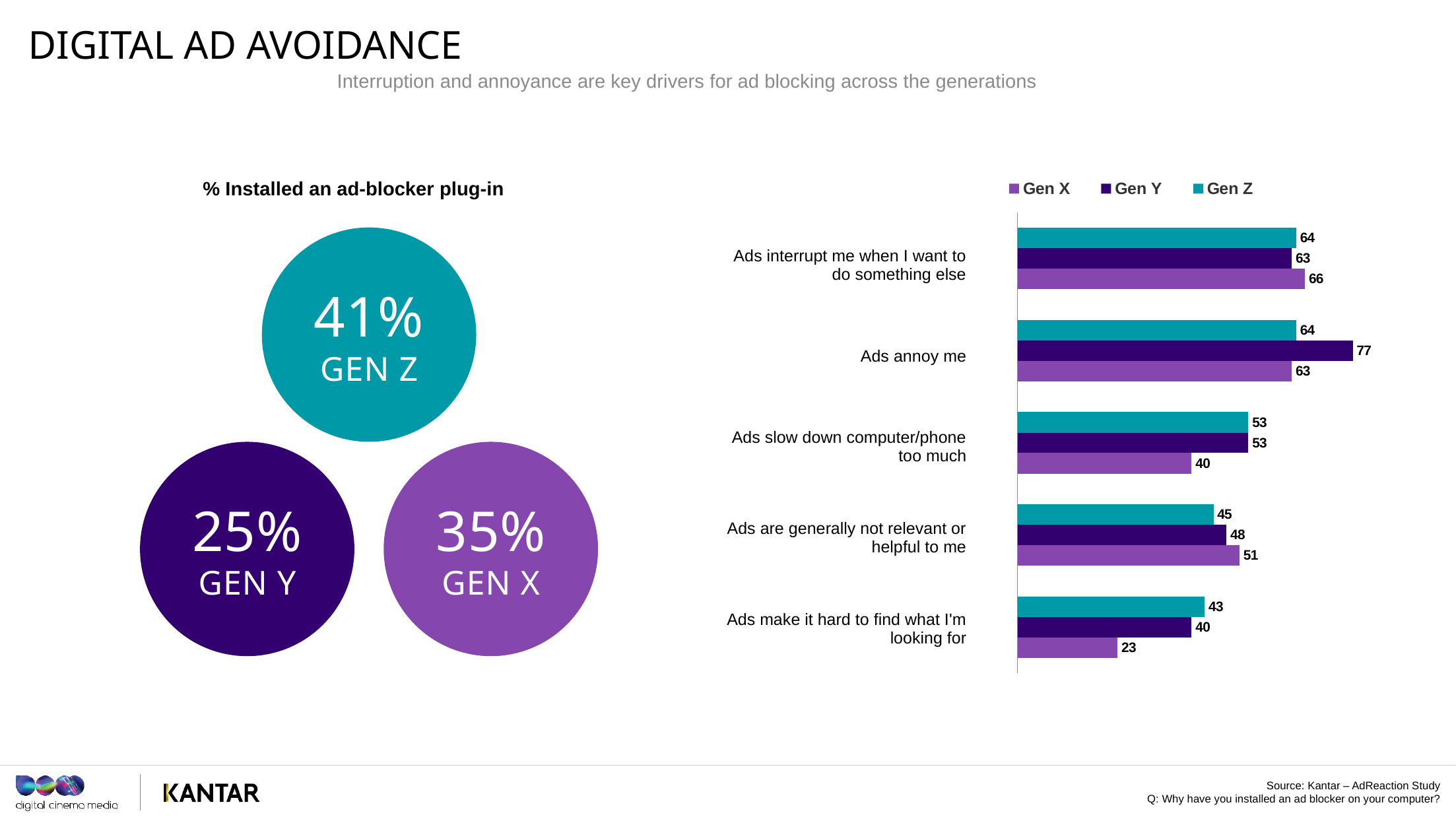
In the bar chart, which generation has the lowest value for 'Ads make it hard to find what I'm looking for'? Gen X In the bar chart, what is the Gen Y value for 'Ads annoy me'? 77 In the bar chart, what is the Gen Z value for 'Ads slow down computer/phone too much'? 53 In the bar chart, what is the difference between the Gen Z and Gen X values for 'Ads slow down computer/phone too much'? 13 In the bar chart, which generation has the highest value for 'Ads annoy me'? Gen Y What type of chart is shown on the right side of the slide? bar chart In the bar chart, what is the Gen X value for 'Ads make it hard to find what I'm looking for'? 23 In the bar chart, which is larger for 'Ads are generally not relevant or helpful to me': the Gen X value or the Gen Z value? Gen X In the bar chart, what is the difference between the Gen Y and Gen X values for 'Ads annoy me'? 14 How many reason categories are shown in the bar chart? 5 Which legend entry in the bar chart is shown in teal? Gen Z How many series does the legend of the bar chart list? 3